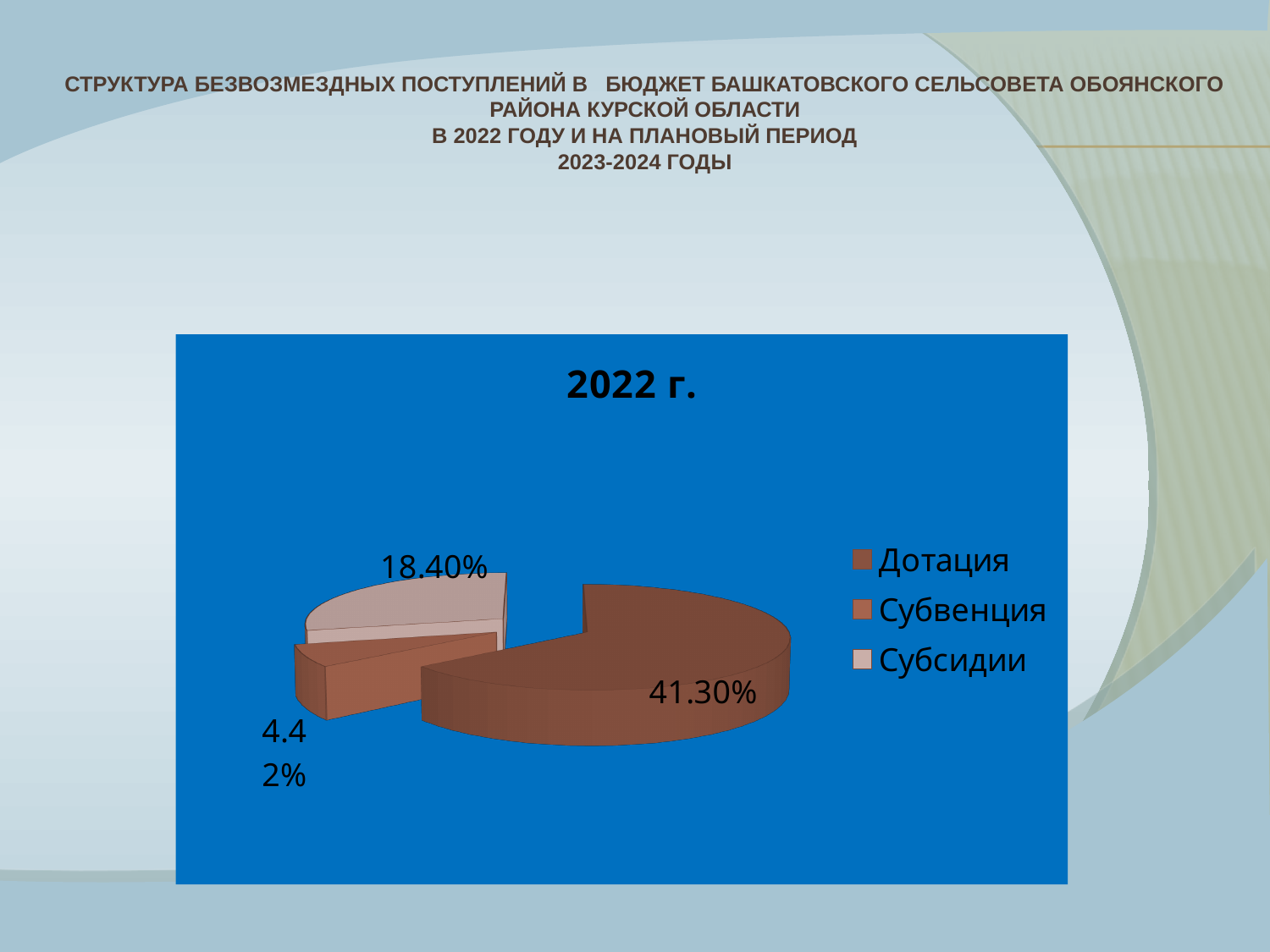
What is the value shown for Субвенция in the 2022 г. pie chart? 4.42% What is the value shown for Субсидии in the 2022 г. pie chart? 18.40% What is the title of the pie chart? 2022 г. What is the difference between the values for Дотация and Субсидии in the 2022 г. pie chart? 22.90% How many entries does the legend of the pie chart list? 3 What is the value shown for Дотация in the 2022 г. pie chart? 41.30% What kind of chart is shown on the slide? pie chart Which category has the largest slice in the 2022 г. pie chart? Дотация What is the difference between the values for Субсидии and Субвенция in the 2022 г. pie chart? 13.98% How many slices does the 2022 г. pie chart have? 3 Which category has the smallest slice in the 2022 г. pie chart? Субвенция Which is larger in the 2022 г. pie chart, Субсидии or Субвенция? Субсидии